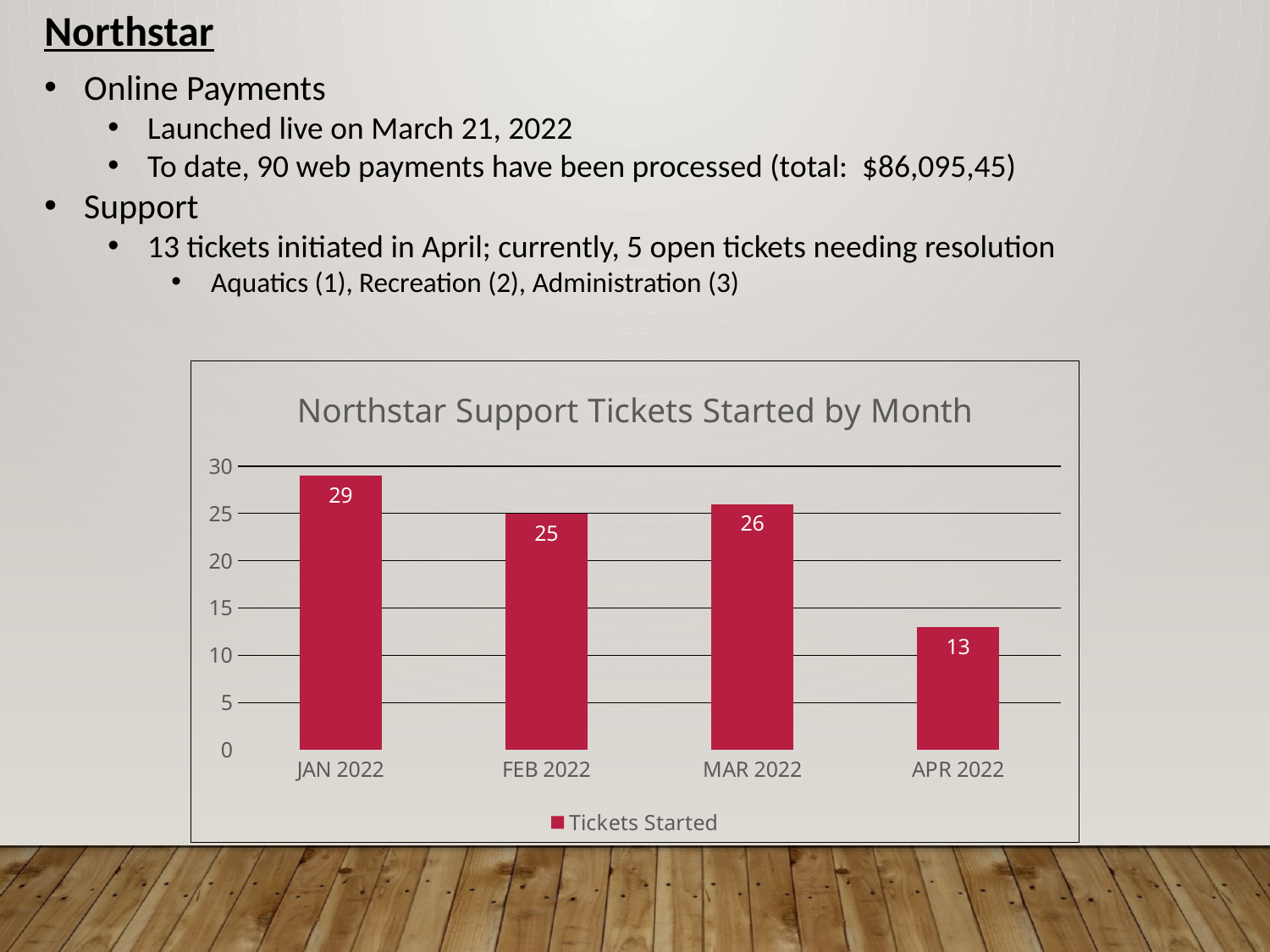
How many support tickets were started in FEB 2022? 25 How many support tickets were started in APR 2022? 13 Which month had more tickets started, MAR 2022 or APR 2022? MAR 2022 What is the difference in tickets started between MAR 2022 and FEB 2022? 1 What is the title of the chart? Northstar Support Tickets Started by Month Is the value for APR 2022 greater or less than 15? less How many support tickets were started in JAN 2022? 29 How many months are shown on the chart? 4 What type of chart is shown on the slide? Bar chart Which month had the lowest number of tickets started? APR 2022 What is the difference in tickets started between JAN 2022 and APR 2022? 16 Which month had the highest number of tickets started? JAN 2022